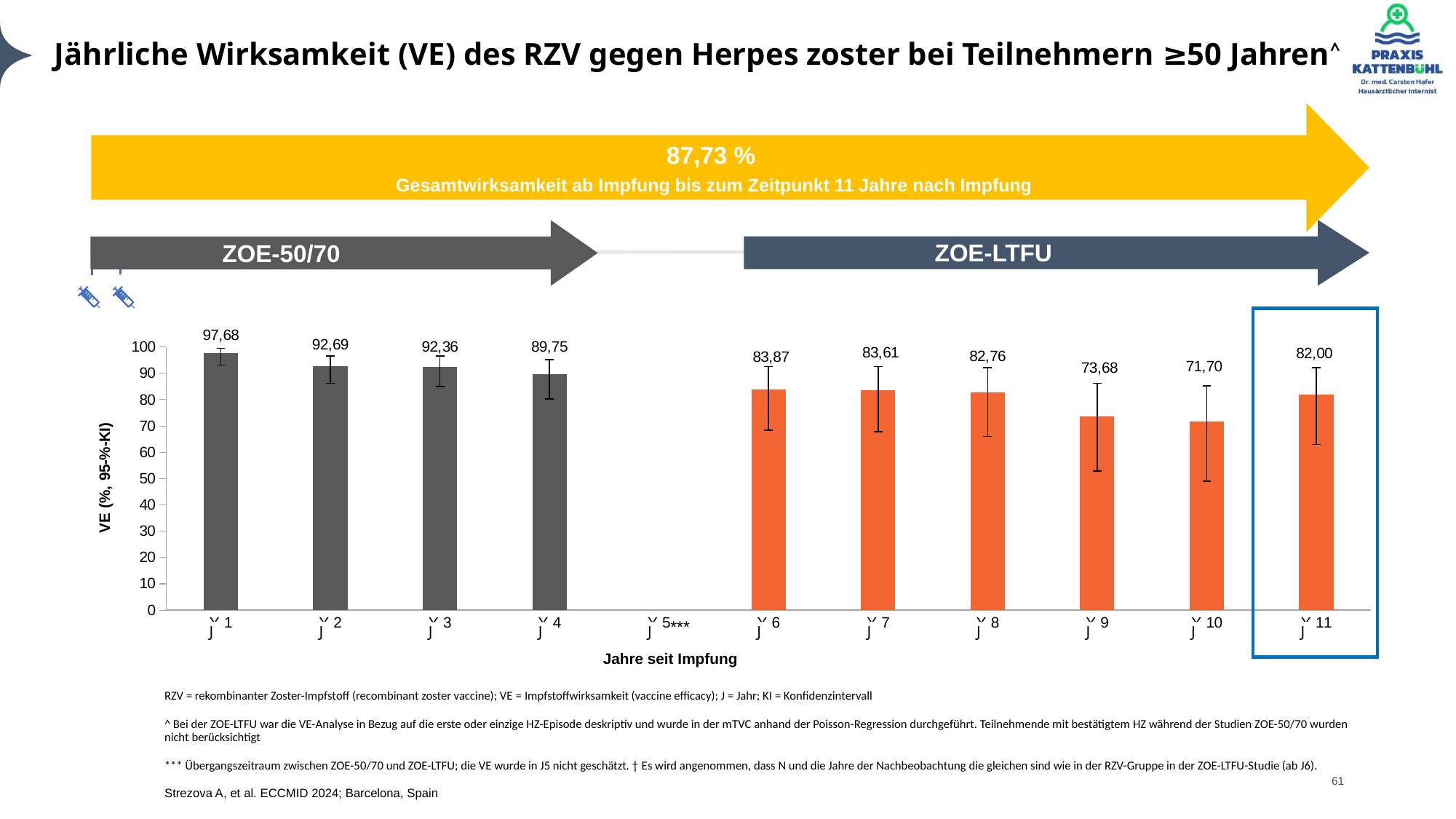
What is the VE value shown for J 1 (year 1 since vaccination)? 97,68 What is the VE value shown for J 9? 73,68 What is the difference between the VE values for J 6 and J 11? 1,87 Which year since vaccination has the lowest VE value among the plotted bars? J 10 Which has a larger VE value, J 4 or J 9? J 4 What is the VE value shown for J 11? 82,00 What is the label of the x axis of the chart? Jahre seit Impfung Is the VE value for J 10 greater or less than 80? less Which year since vaccination has the highest VE value? J 1 What kind of chart is shown on the slide? bar chart How many bars are plotted in the chart? 10 What is the difference between the VE values for J 1 and J 10? 25,98